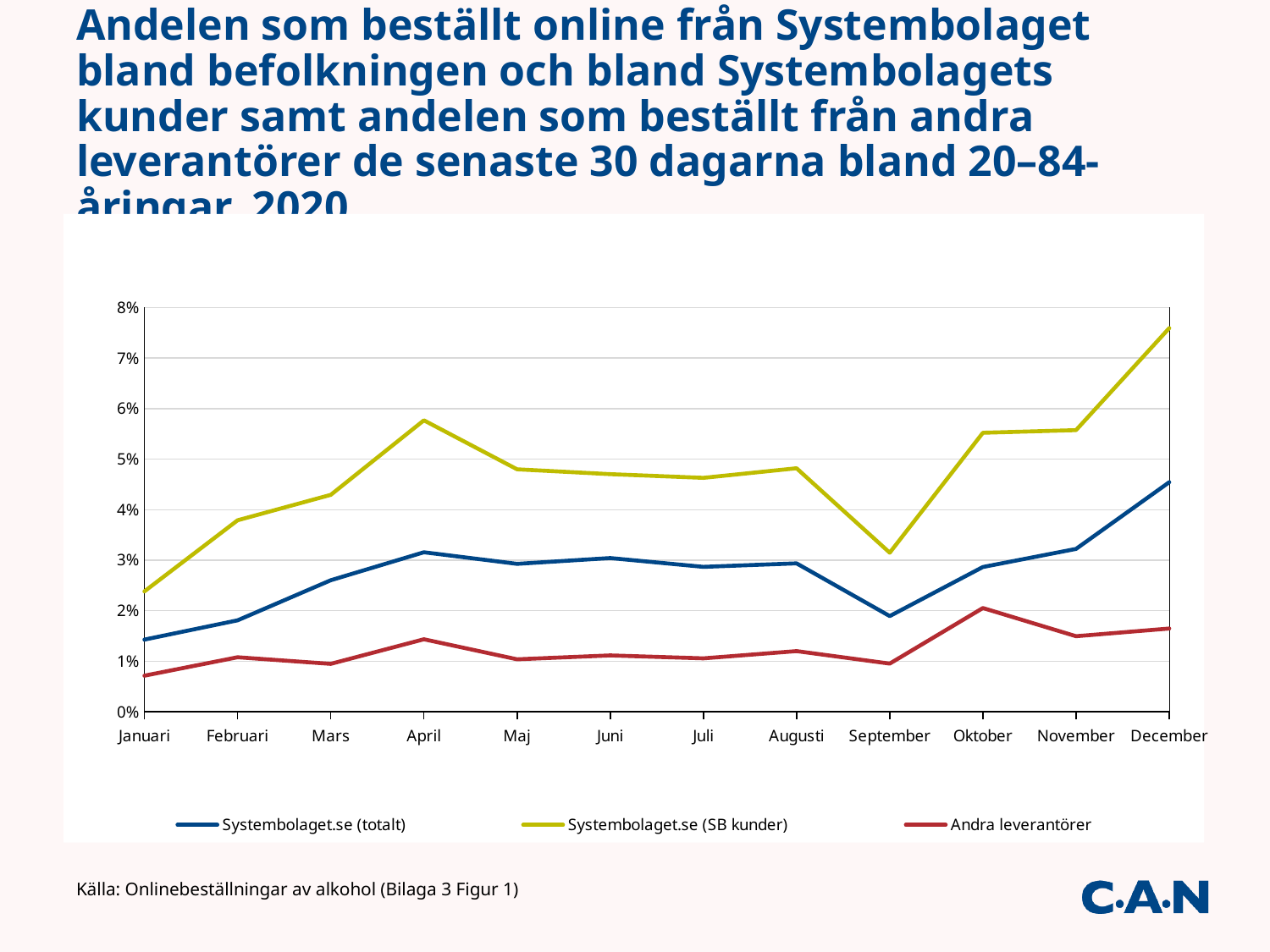
How many series does the legend list? 3 Is the value for Systembolaget.se (SB kunder) in December greater or less than 7%? greater What kind of chart is shown on the slide? line chart In which month is the value for Systembolaget.se (SB kunder) lowest? Januari Does the value for Systembolaget.se (SB kunder) rise or fall from September to December? rise In which month is the value for Systembolaget.se (SB kunder) highest? December What colour is the line for Andra leverantörer? red How many months are shown along the x axis? 12 In which month is the value for Andra leverantörer highest? Oktober In which month is the value for Systembolaget.se (totalt) lowest? Januari Which is larger for Systembolaget.se (totalt): the value in April or the value in December? December